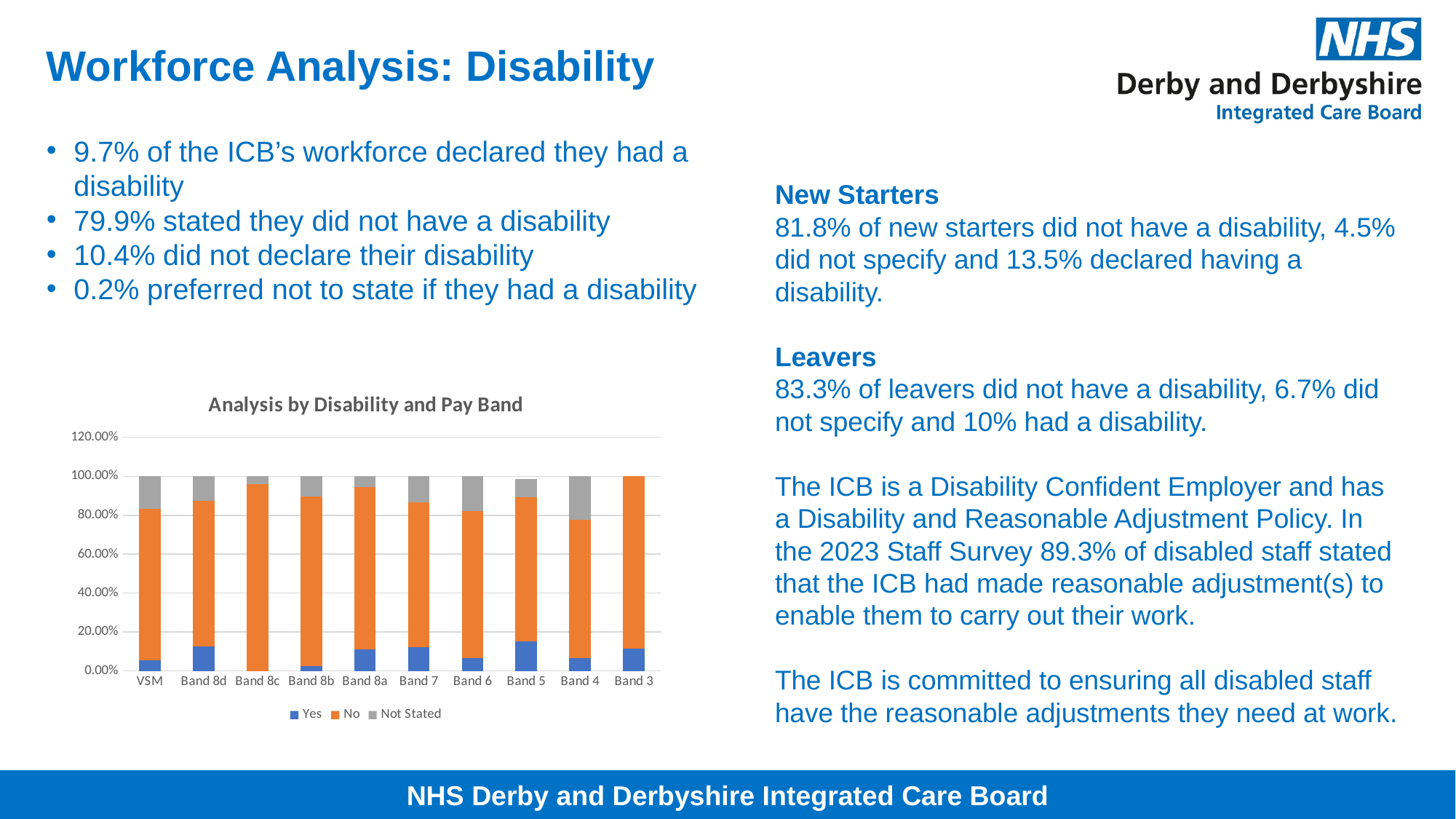
Which pay band shows no 'Not Stated' segment at all? Band 3 How many series does the chart legend list? 3 What kind of chart is shown on the slide? Stacked bar chart Is the 'No' value for Band 8c greater or less than 80.00%? greater Which pay band has the largest 'Not Stated' share in the chart? Band 4 Which pay band has the smallest 'Yes' share in the chart? Band 8c Is the 'Yes' value for VSM greater or less than 20.00%? less Which is larger, the 'Yes' share for Band 5 or the 'Yes' share for Band 8b? Band 5 Which colour represents the 'No' series in the chart? Orange How many pay band categories are shown on the x axis of the chart? 10 Is the 'Yes' value for Band 5 greater or less than 20.00%? less What is the title of the chart? Analysis by Disability and Pay Band